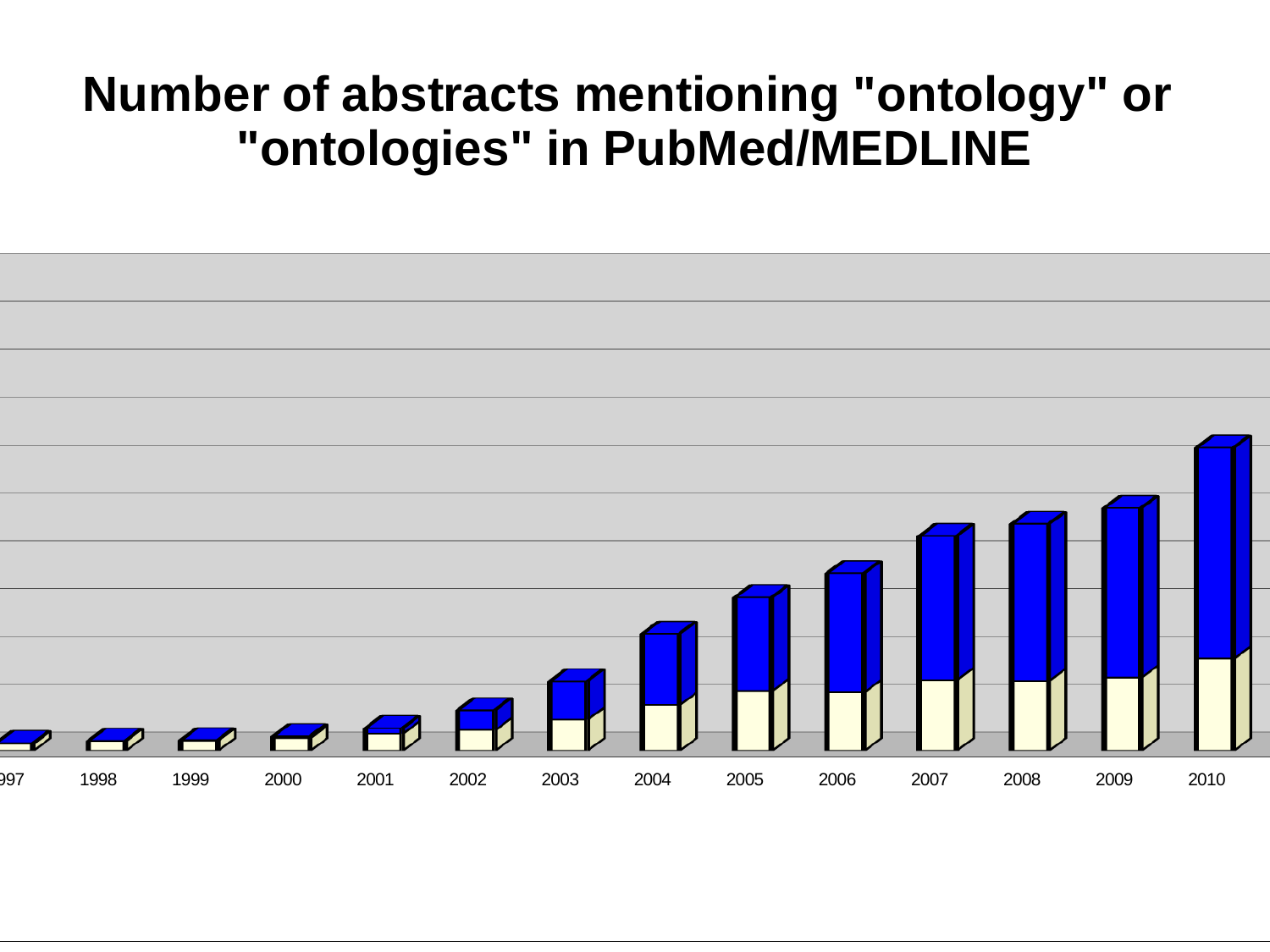
Which bar is taller, 2006 or 2005? 2006 Do the bar heights generally rise or fall from 1998 to 2010? Rise Which year has the tallest bar? 2010 Which bar is taller, 2010 or 2009? 2010 What is the last year shown on the x axis? 2010 What is the title of the chart? Number of abstracts mentioning "ontology" or "ontologies" in PubMed/MEDLINE Which bar is shorter, 2001 or 2004? 2001 What two colours are used for the segments of each bar? Blue and cream What kind of chart is shown on the slide? Stacked bar chart